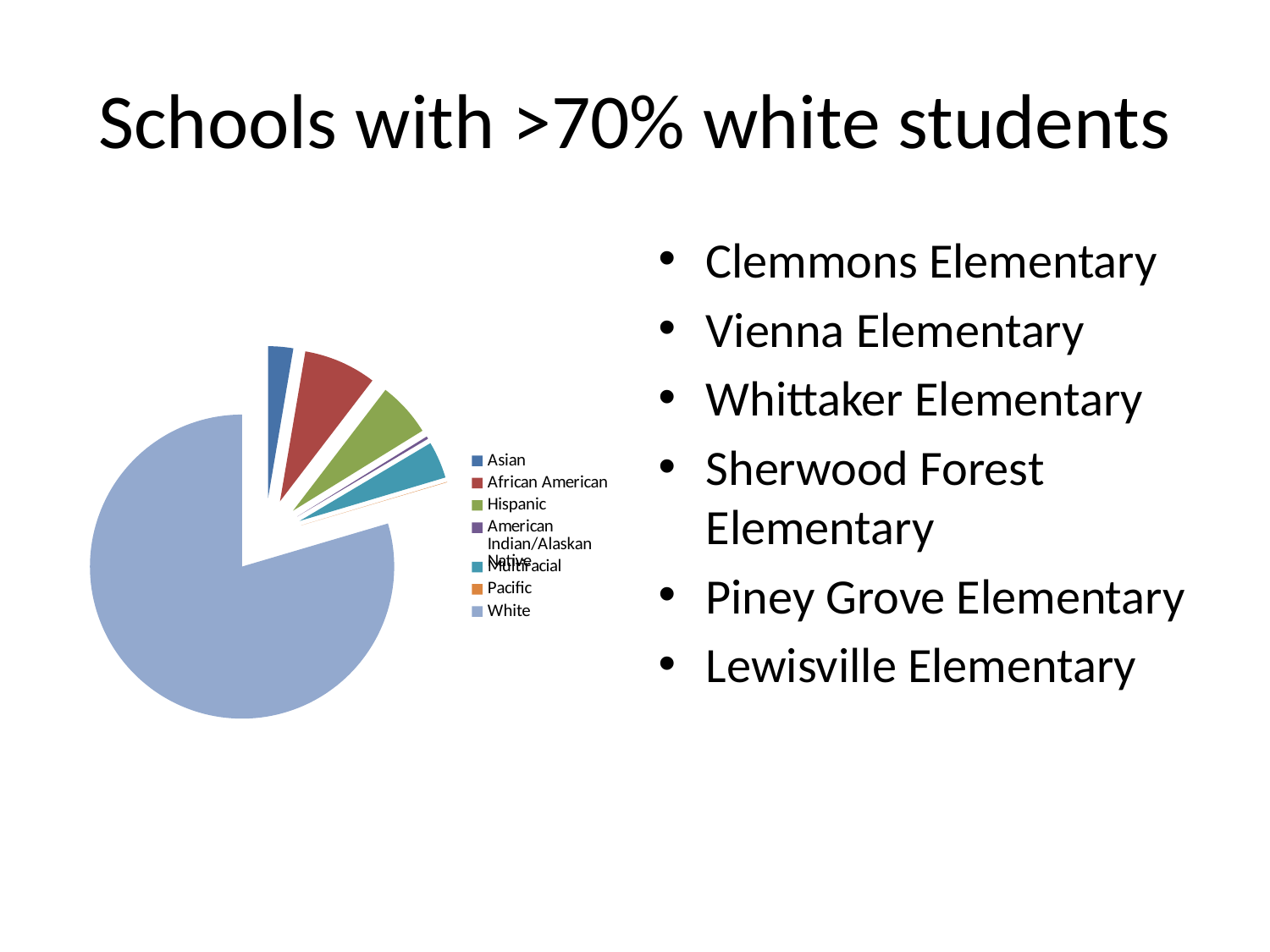
Which legend entry is listed first in the pie chart's legend? Asian How many entries does the legend of the pie chart list? 7 How many categories does the pie chart show? 7 Which slice is larger in the pie chart, African American or Asian? African American Which slice is larger in the pie chart, Hispanic or Pacific? Hispanic What kind of chart is shown on the slide? pie chart Which slice is larger in the pie chart, White or Hispanic? White Which category has the largest slice of the pie chart? White What colour is the White slice in the pie chart? light blue